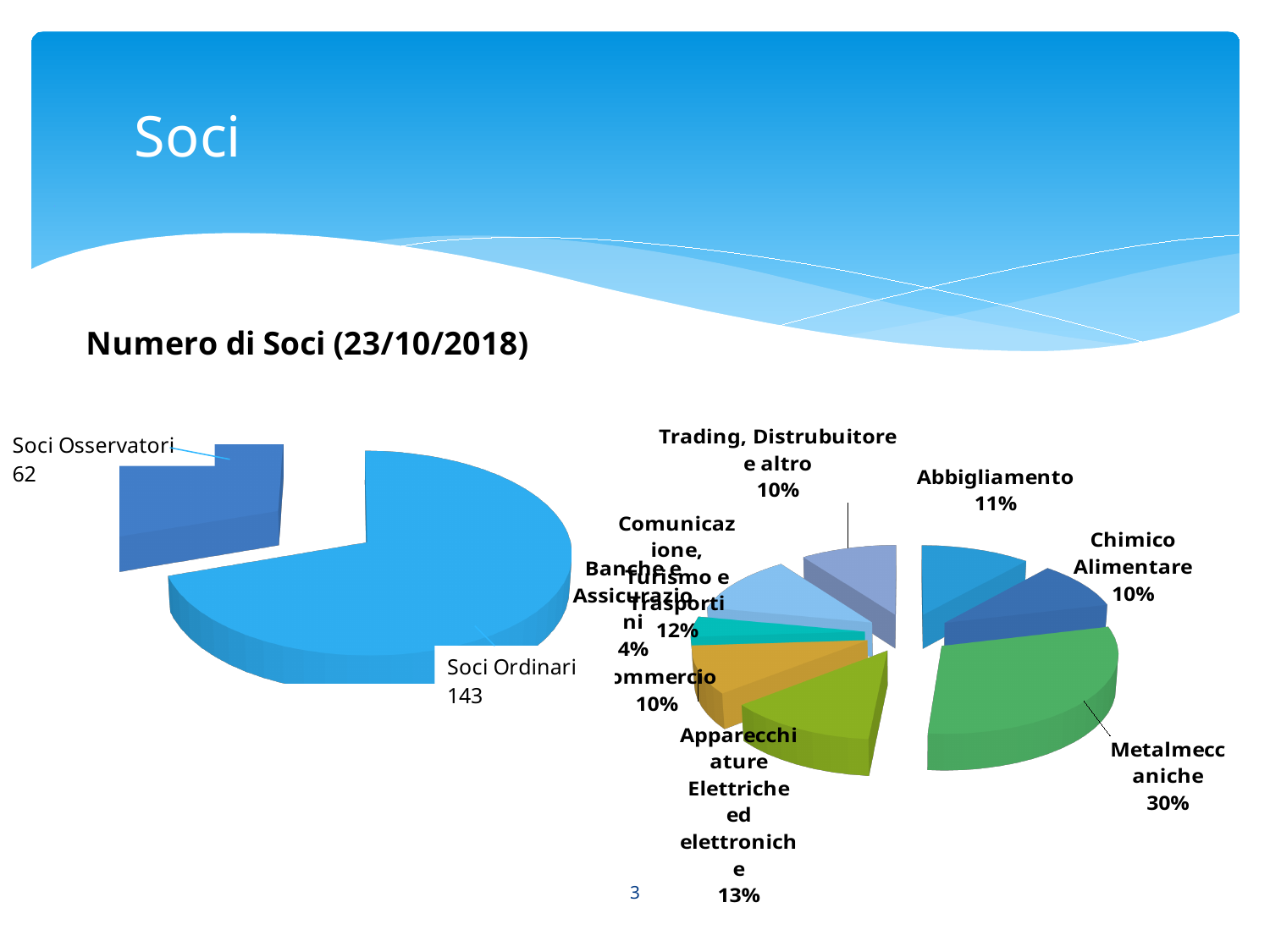
On the left pie chart (Numero di Soci), how many slices are there? 2 On the right pie chart, what is the difference in share between Metalmeccaniche and Apparecchiature Elettriche ed elettroniche? 17% On the left pie chart (Numero di Soci), what is the difference between Soci Ordinari and Soci Osservatori? 81 On the right pie chart, which is larger: Abbigliamento or Chimico Alimentare? Abbigliamento On the right pie chart, which sector has the largest share? Metalmeccaniche On the left pie chart (Numero di Soci), how many Soci Osservatori are there? 62 On the right pie chart, what share does Metalmeccaniche have? 30% On the left pie chart (Numero di Soci), how many Soci Ordinari are there? 143 On the right pie chart, what share does Abbigliamento have? 11% What kind of chart is the left chart (Numero di Soci)? Pie chart On the right pie chart, what share does Apparecchiature Elettriche ed elettroniche have? 13% On the left pie chart (Numero di Soci), what is the total number of Soci across both slices? 205